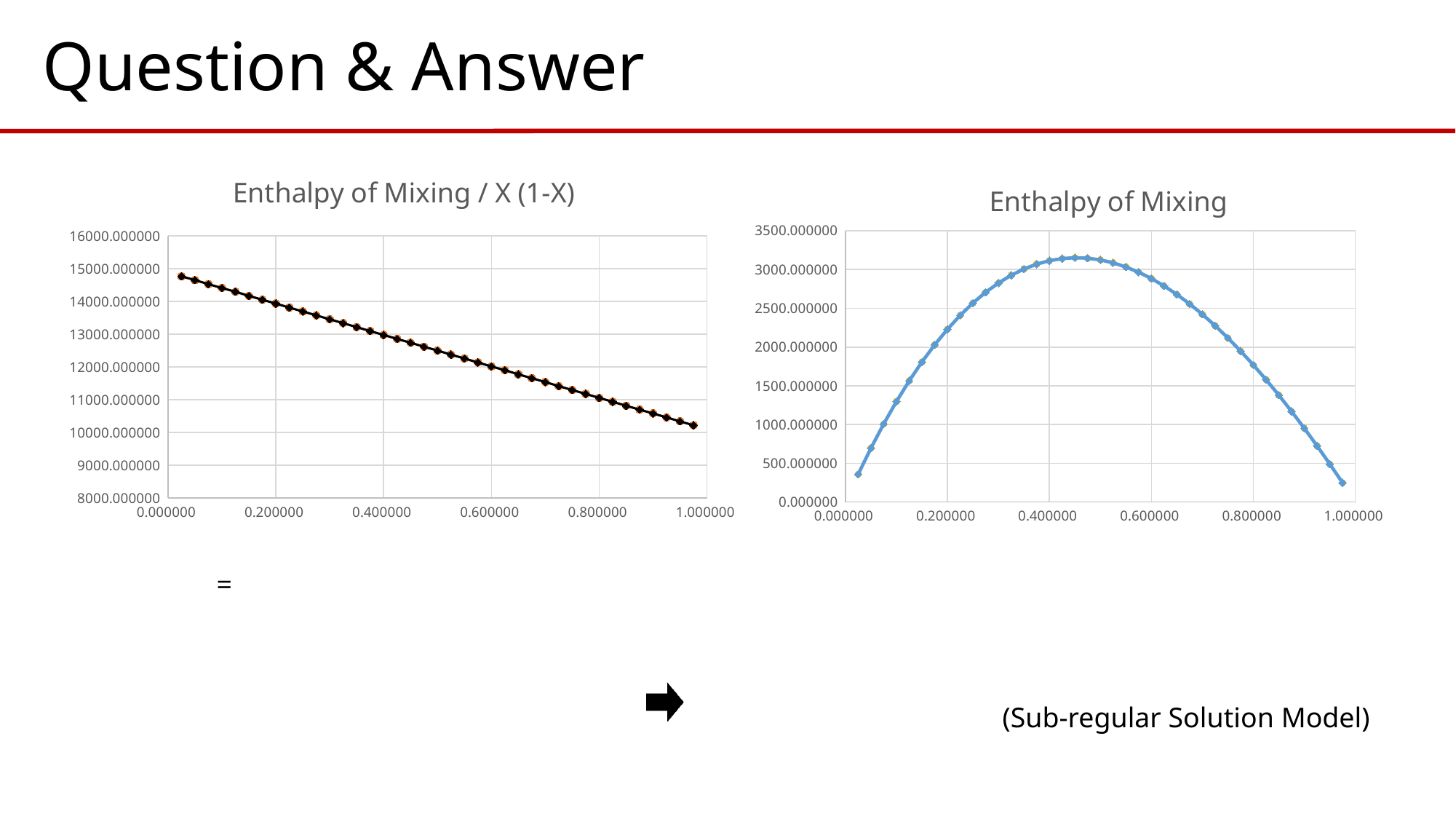
What is the title of the chart on the left of the slide? Enthalpy of Mixing / X (1-X) In the "Enthalpy of Mixing / X (1-X)" chart on the left, which is larger: the value at x = 0.200000 or the value at x = 0.800000? the value at x = 0.200000 In the "Enthalpy of Mixing / X (1-X)" chart on the left, is the value at x = 0.200000 greater or less than 15000? less In the "Enthalpy of Mixing / X (1-X)" chart on the left, do the values rise or fall as x increases from 0 to 1? fall In the "Enthalpy of Mixing" chart on the right, is the highest value greater or less than 3000? greater In the "Enthalpy of Mixing / X (1-X)" chart on the left, is the value at x = 0.100000 greater or less than 14000? greater What kind of chart is the "Enthalpy of Mixing" chart on the right? line chart In the "Enthalpy of Mixing" chart on the right, do the values rise or fall as x increases from 0.000000 to 0.400000? rise In the "Enthalpy of Mixing" chart on the right, do the values rise or fall as x increases from 0.600000 to 1.000000? fall